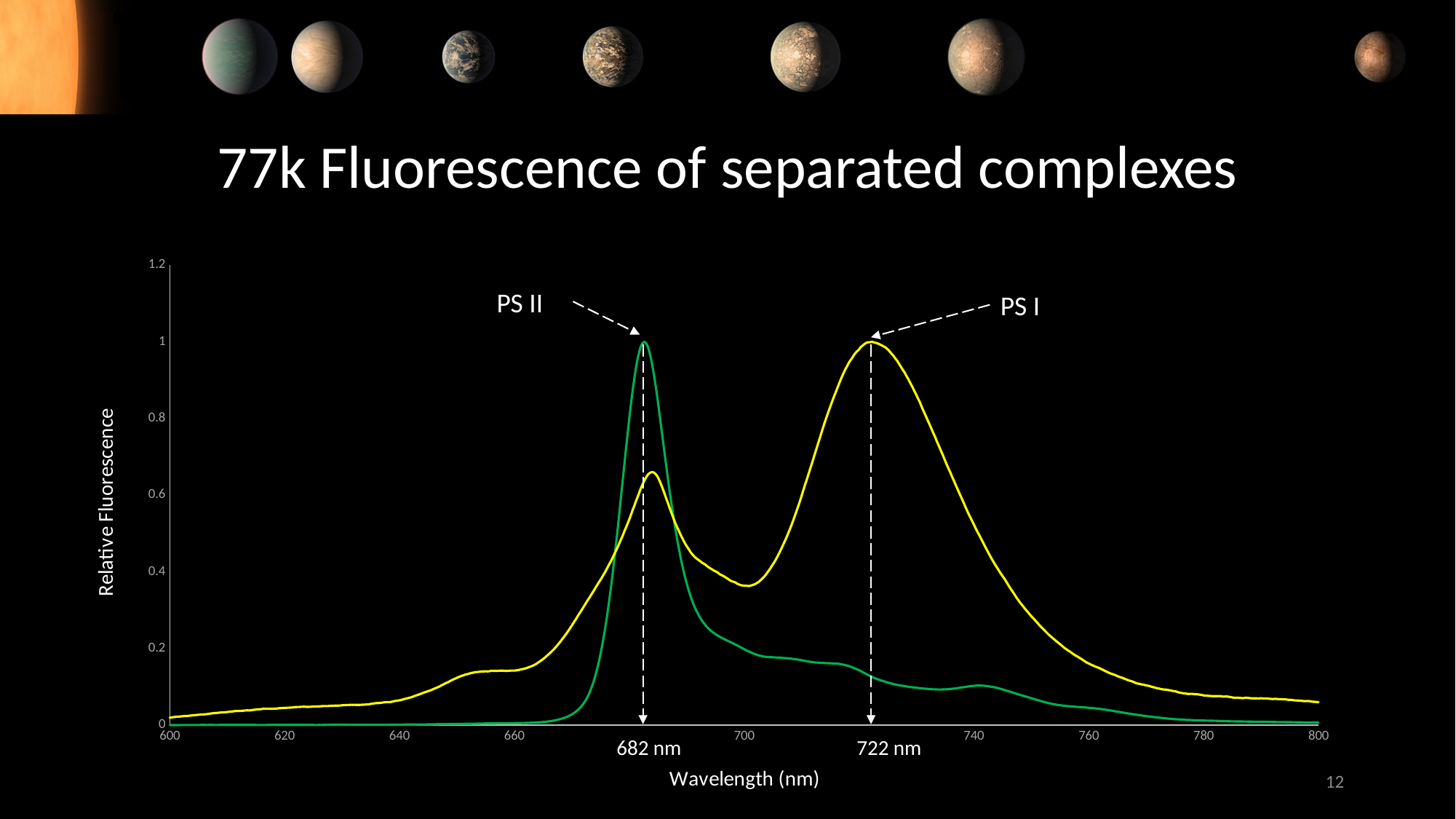
Is the relative fluorescence of the yellow (PS I) curve at 700 nm greater or less than 0.6? less Which complex, PS I or PS II, has its fluorescence peak at the longer wavelength? PS I What is the title of the slide? 77k Fluorescence of separated complexes At 682 nm, which curve has the higher relative fluorescence, the green (PS II) or the yellow (PS I)? green (PS II) At what wavelength does the PS I curve reach its peak? 722 nm What is the label of the x axis? Wavelength (nm) What is the maximum relative fluorescence reached by the PS II curve? 1 Is the relative fluorescence of the green (PS II) curve at 722 nm greater or less than 0.2? less At 722 nm, which curve has the higher relative fluorescence, the green (PS II) or the yellow (PS I)? yellow (PS I) At what wavelength does the PS II curve reach its peak? 682 nm What kind of chart is shown on the slide? line chart How many curves are plotted on the chart? 2